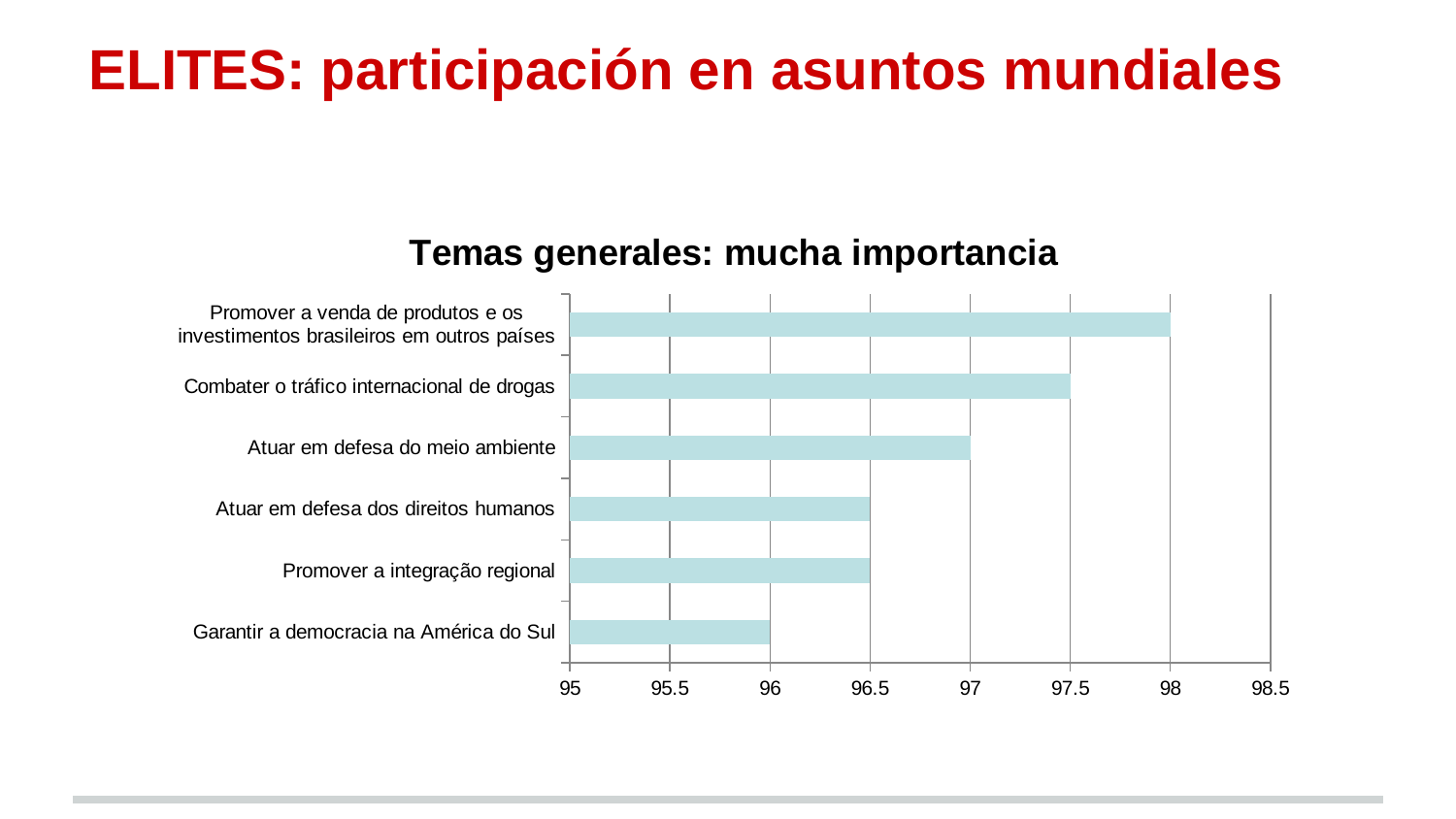
Which is larger: the value for "Atuar em defesa do meio ambiente" or the value for "Promover a integração regional"? Atuar em defesa do meio ambiente What is the value for "Atuar em defesa do meio ambiente"? 97 What is the difference between the value for "Combater o tráfico internacional de drogas" and the value for "Atuar em defesa dos direitos humanos"? 1 Which category has the highest value? Promover a venda de produtos e os investimentos brasileiros em outros países How many categories are plotted in the chart? 6 What is the value for "Combater o tráfico internacional de drogas"? 97.5 What is the title of the chart? Temas generales: mucha importancia What type of chart is shown on the slide? Bar chart What is the value for "Garantir a democracia na América do Sul"? 96 What is the difference between the value for "Promover a venda de produtos e os investimentos brasileiros em outros países" and the value for "Garantir a democracia na América do Sul"? 2 Is the value for "Atuar em defesa dos direitos humanos" greater or less than 97? less Which category has the lowest value? Garantir a democracia na América do Sul